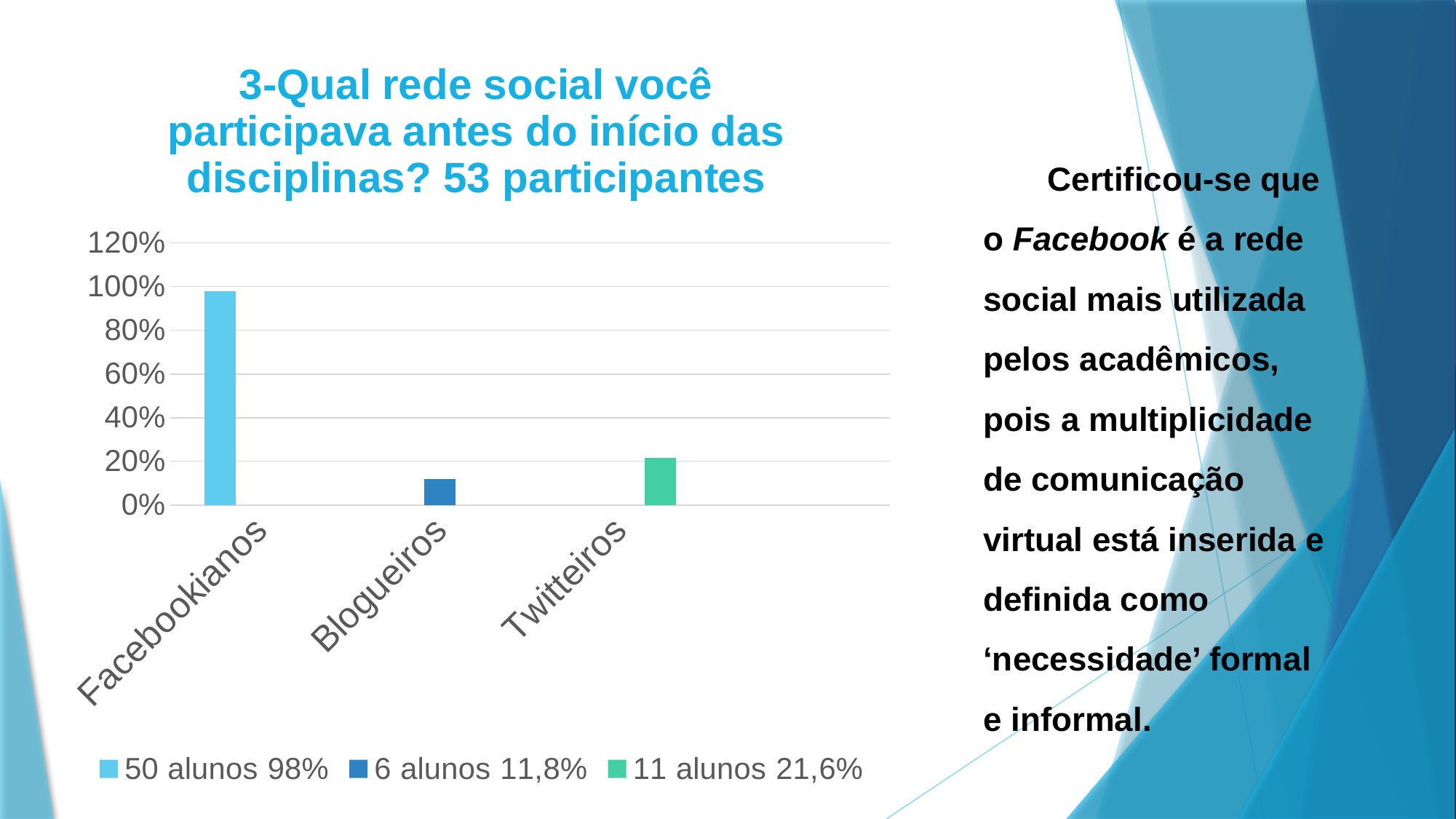
Which category has the highest bar in the chart? Facebookianos Which bar is taller, Twitteiros or Blogueiros? Twitteiros How many categories are shown on the x axis of the chart? 3 According to the legend, what percentage corresponds to the Facebookianos bar (50 alunos)? 98% Which category has the lowest bar in the chart? Blogueiros Is the value for Twitteiros greater or less than 40%? less Is the value for Facebookianos greater or less than 80%? greater What kind of chart is shown on the slide? bar chart According to the legend, what percentage corresponds to the Twitteiros bar (11 alunos)? 21,6% How many entries does the chart's legend list? 3 What is the title of the chart? 3-Qual rede social você participava antes do início das disciplinas? 53 participantes Is the value for Blogueiros greater or less than 20%? less